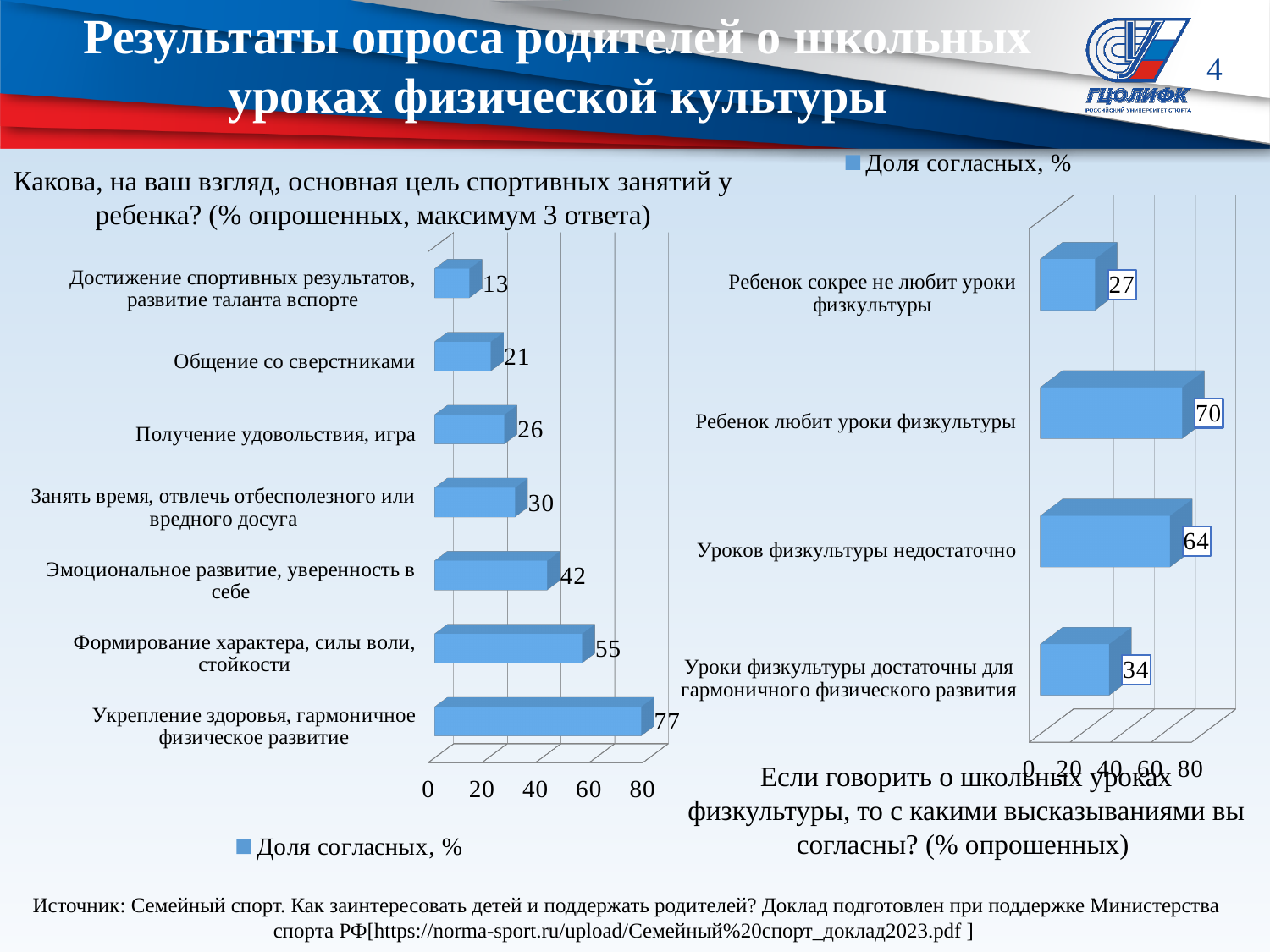
What type of chart is the right chart (Если говорить о школьных уроках физкультуры...)? Bar chart In the left chart (Какова, на ваш взгляд, основная цель спортивных занятий у ребенка?), how many categories are shown? 7 In the left chart (Какова, на ваш взгляд, основная цель спортивных занятий у ребенка?), what is the value for «Укрепление здоровья, гармоничное физическое развитие»? 77 In the right chart (Если говорить о школьных уроках физкультуры...), what is the difference between «Уроков физкультуры недостаточно» and «Уроки физкультуры достаточны для гармоничного физического развития»? 30 In the left chart (Какова, на ваш взгляд, основная цель спортивных занятий у ребенка?), which is larger: «Получение удовольствия, игра» or «Занять время, отвлечь отбесполезного или вредного досуга»? Занять время, отвлечь отбесполезного или вредного досуга In the left chart (Какова, на ваш взгляд, основная цель спортивных занятий у ребенка?), which category has the lowest value? Достижение спортивных результатов, развитие таланта вспорте In the right chart (Если говорить о школьных уроках физкультуры...), which statement has the highest share of agreement? Ребенок любит уроки физкультуры In the right chart (Если говорить о школьных уроках физкультуры...), how many statements are shown? 4 In the right chart (Если говорить о школьных уроках физкультуры...), what is the value for «Ребенок любит уроки физкультуры»? 70 In the left chart (Какова, на ваш взгляд, основная цель спортивных занятий у ребенка?), what is the value for «Общение со сверстниками»? 21 What is the legend entry shown for the left chart (Какова, на ваш взгляд, основная цель спортивных занятий у ребенка?)? Доля согласных, % In the left chart (Какова, на ваш взгляд, основная цель спортивных занятий у ребенка?), what is the difference between «Формирование характера, силы воли, стойкости» and «Эмоциональное развитие, уверенность в себе»? 13